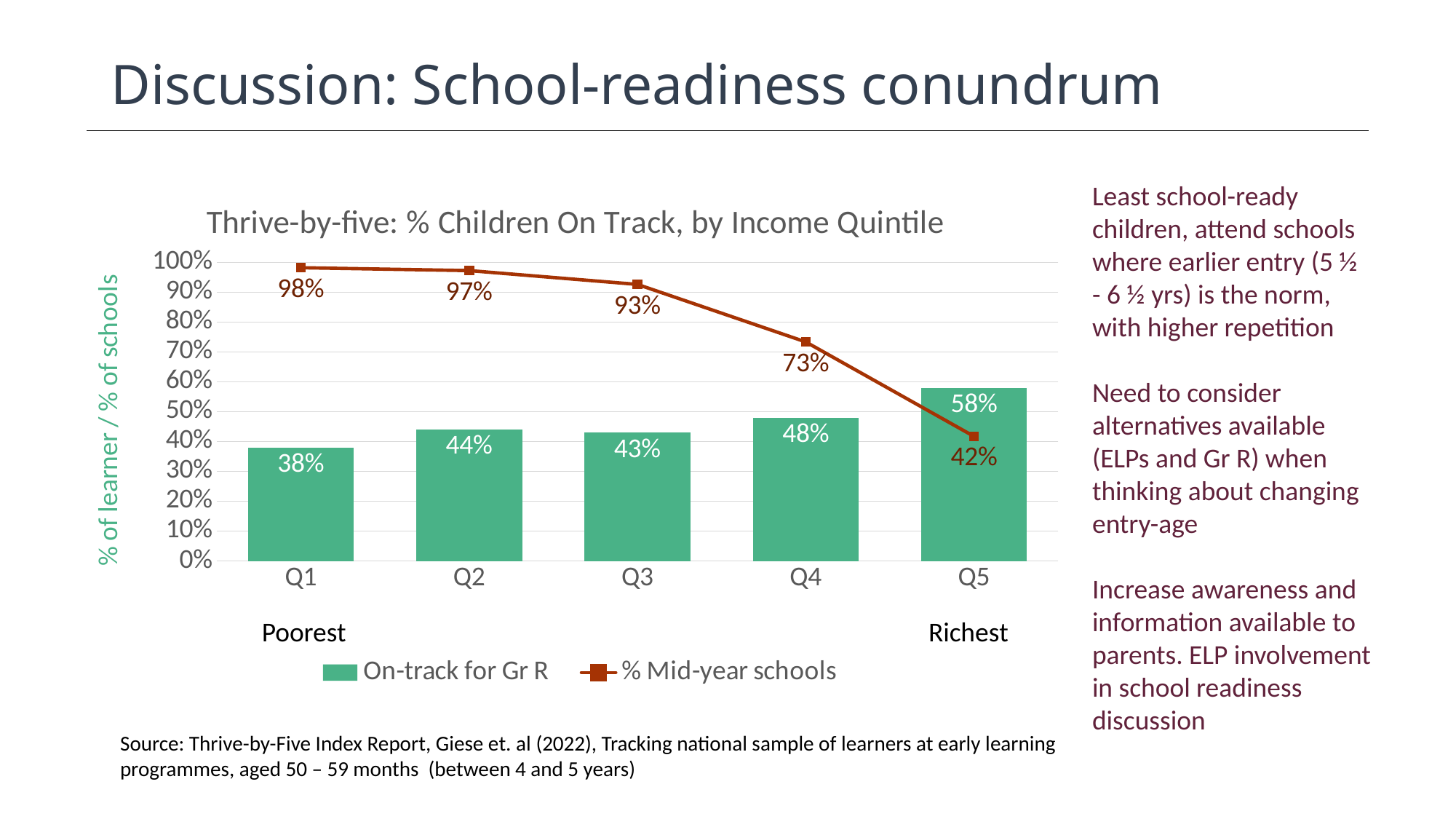
Does the % Mid-year schools line rise or fall from Q1 to Q5? Fall How many income quintiles are shown on the x axis? 5 Which quintile has the highest On-track for Gr R value? Q5 What kind of chart is used for the On-track for Gr R series? Bar chart What is the difference between the % Mid-year schools values for Q1 and Q5? 56% What is the % Mid-year schools value for Q4? 73% How many series does the legend list? 2 What is the On-track for Gr R value for Q1? 38% Which quintile has the lowest % Mid-year schools value? Q5 Which is larger, the On-track for Gr R value for Q2 or for Q3? Q2 What is the title of the chart? Thrive-by-five: % Children On Track, by Income Quintile What is the On-track for Gr R value for Q5? 58%